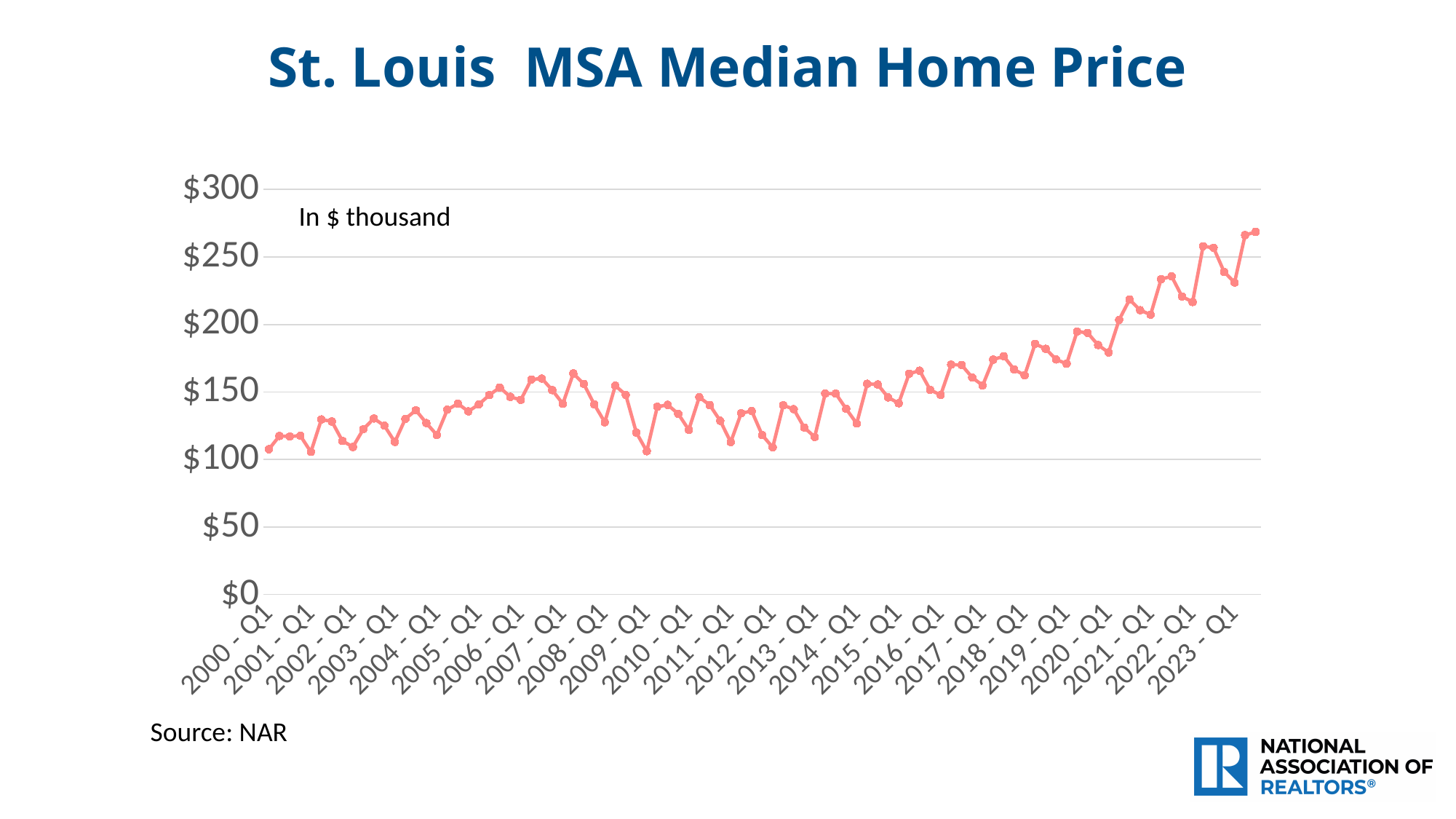
Between 2007 - Q1 and 2010 - Q1, does the line generally rise or fall? fall Is the value for 2012 - Q1 greater or less than $150? less How many year labels are shown on the x axis? 24 In what units are the values on the chart expressed, according to the note on the chart? In $ thousand What kind of chart is shown on the slide? line chart Is the value for 2019 - Q1 greater or less than $150? greater Overall, does the median home price rise or fall from 2000 - Q1 to the end of the series? rise Is the value for 2008 - Q1 greater or less than $150? less What is the title of the chart? St. Louis MSA Median Home Price In which year does the line reach its highest value? 2023